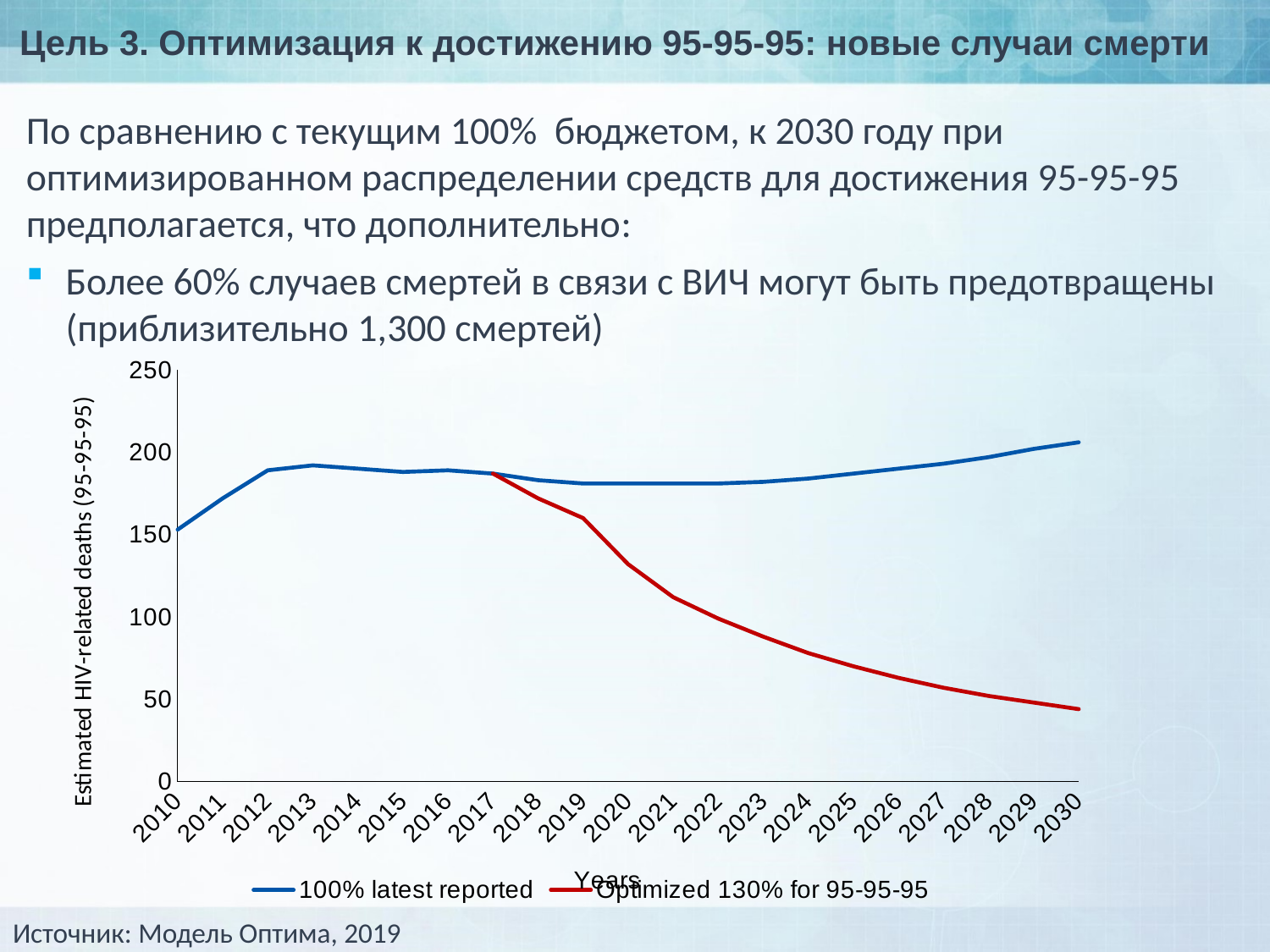
Is the value for 'Optimized 130% for 95-95-95' in 2030 greater or less than 50? less How many years are shown along the x axis? 21 Is the value for 'Optimized 130% for 95-95-95' in 2025 greater or less than 100? less What kind of chart is shown on the slide? line chart What is the label of the y axis? Estimated HIV-related deaths (95-95-95) Does the '100% latest reported' line rise or fall from 2020 to 2030? rise What colour is the line for 'Optimized 130% for 95-95-95'? red How many series does the legend list? 2 In 2030, which series has the higher value: '100% latest reported' or 'Optimized 130% for 95-95-95'? 100% latest reported Does the 'Optimized 130% for 95-95-95' line rise or fall from 2017 to 2030? fall Is the value for '100% latest reported' in 2030 greater or less than 150? greater